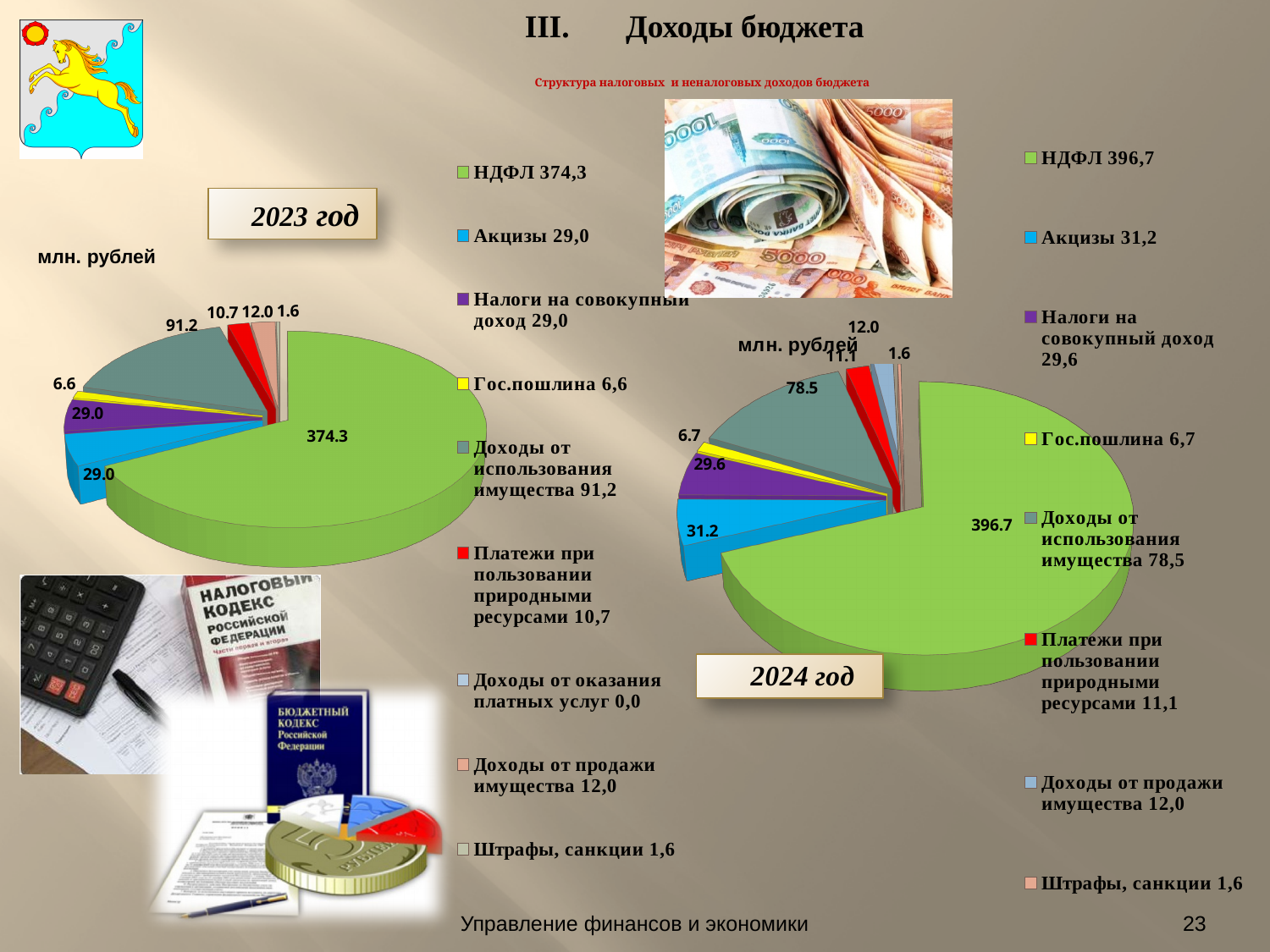
How many entries does the legend of the 2024 год chart list? 8 In the 2023 год chart, which category has the smallest value? Доходы от оказания платных услуг In the 2024 год chart, which category has the smallest value? Штрафы, санкции What type of chart is used for the 2023 год chart? pie chart What unit is shown for the values in both pie charts? млн. рублей Which is larger: Доходы от использования имущества in the 2023 год chart or in the 2024 год chart? 2023 год What is the difference between НДФЛ in the 2024 год chart and НДФЛ in the 2023 год chart? 22.4 In the 2024 год chart, what is the value for Доходы от использования имущества? 78.5 In the 2023 год chart, what is the difference between Доходы от использования имущества and Акцизы? 62.2 In the 2023 год chart, what is the value for НДФЛ? 374.3 In the 2024 год chart, what is the value for Акцизы? 31.2 In the 2023 год chart, which category has the largest value? НДФЛ